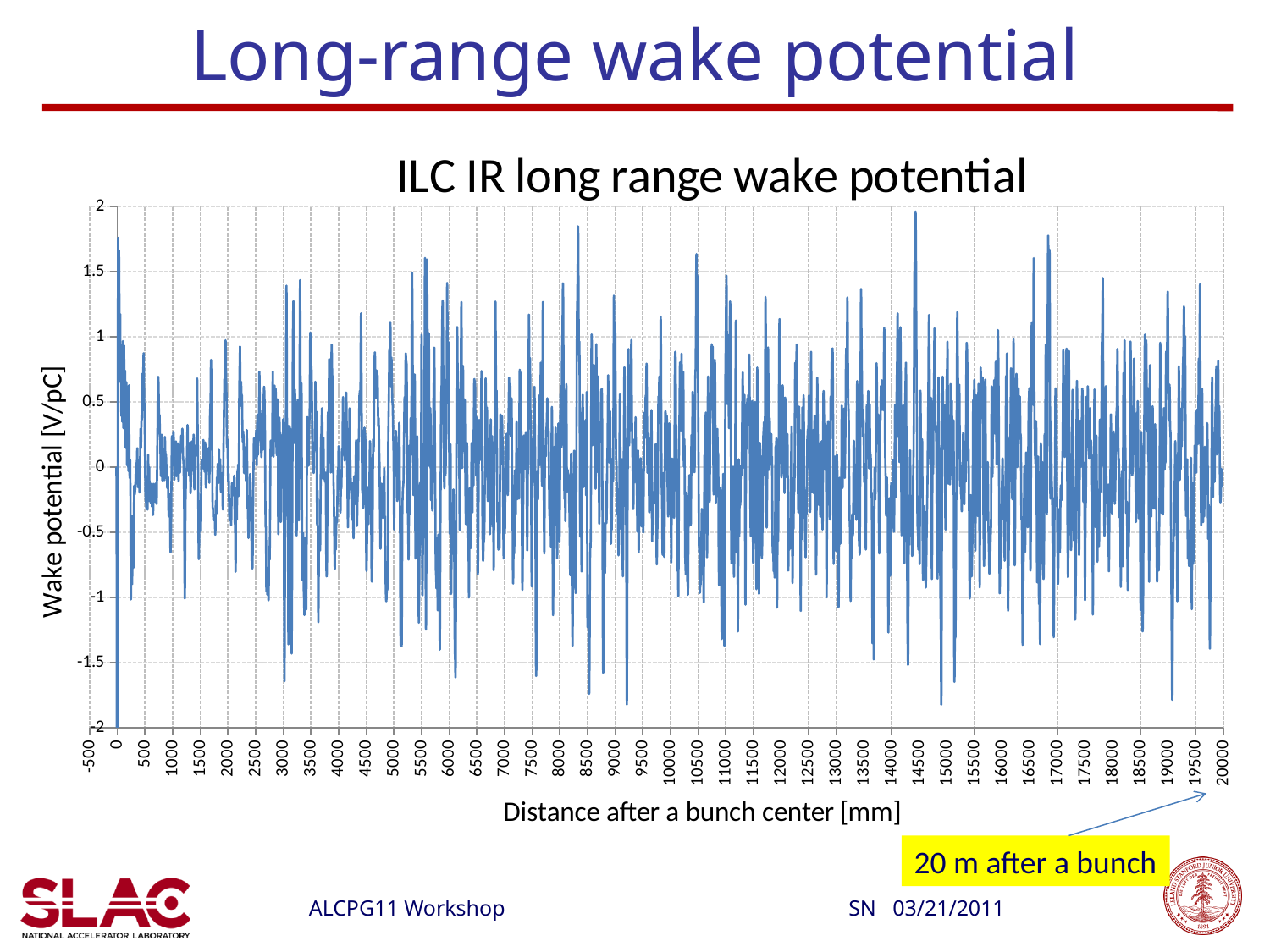
Is the lowest dip of the wake potential greater or less than -1.5 V/pC? less Is the peak of the wake potential at the very start of the trace (near 0 mm) greater or less than 1 V/pC? greater What is the title of the chart? ILC IR long range wake potential Is the peak of the wake potential near 8500 mm greater or less than 1.5 V/pC? greater What is the label of the y axis of the chart? Wake potential [V/pC] What kind of chart is shown on the slide? line chart